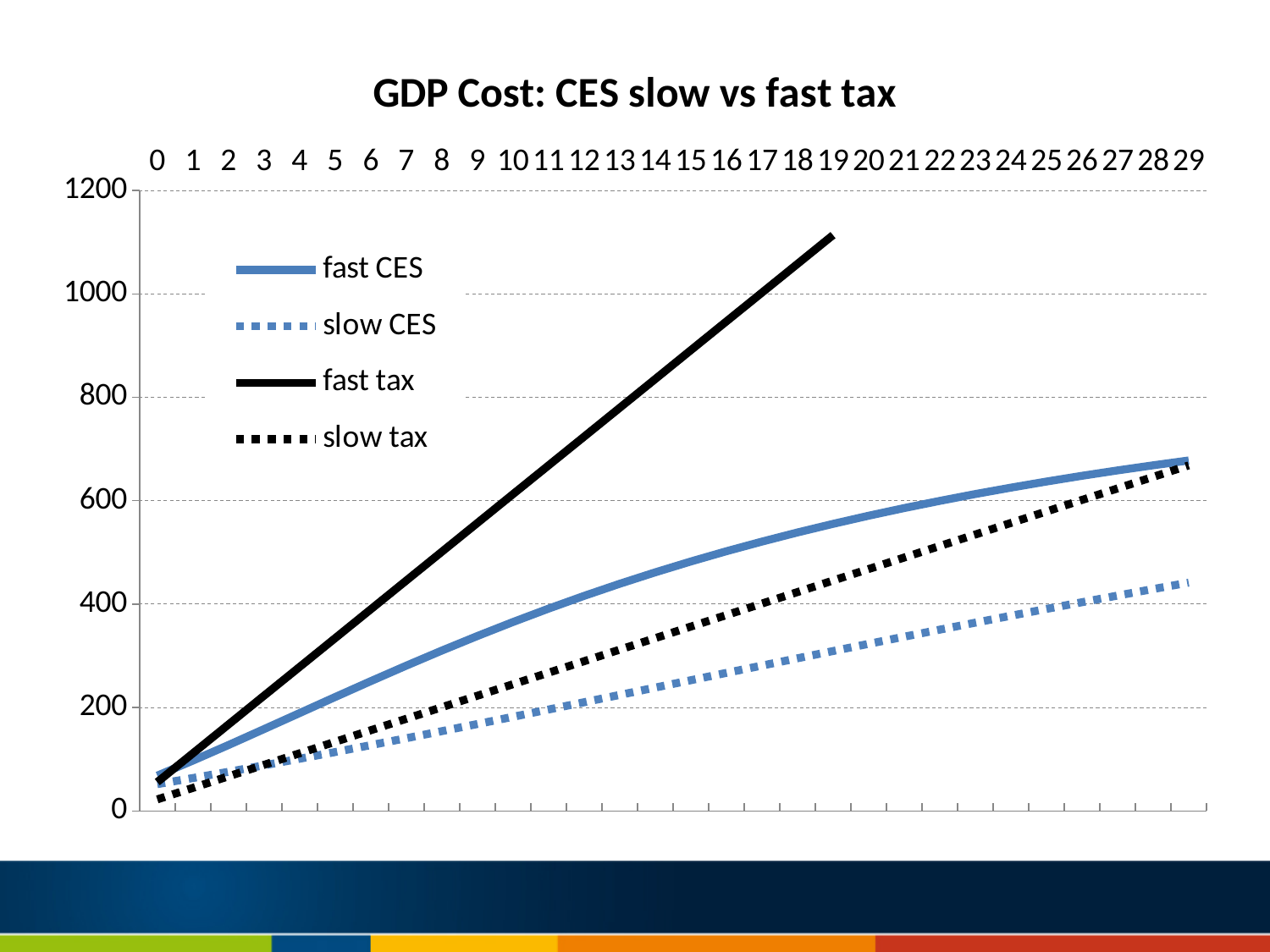
How many series does the legend list? 4 At x = 10, which is larger: fast tax or fast CES? fast tax Which series has the lowest value at x = 29? slow CES How many points are labelled along the x axis? 30 Which series is drawn as a solid black line? fast tax At x = 15, which is larger: slow tax or slow CES? slow tax Which series reaches the highest value on the chart? fast tax What kind of chart is shown on the slide? line chart Is the value for fast tax at x = 19 greater or less than 1000? greater Is the value for slow CES at x = 29 greater or less than 600? less Do the values of the fast CES series rise or fall along the x axis? rise What is the title of the chart? GDP Cost: CES slow vs fast tax